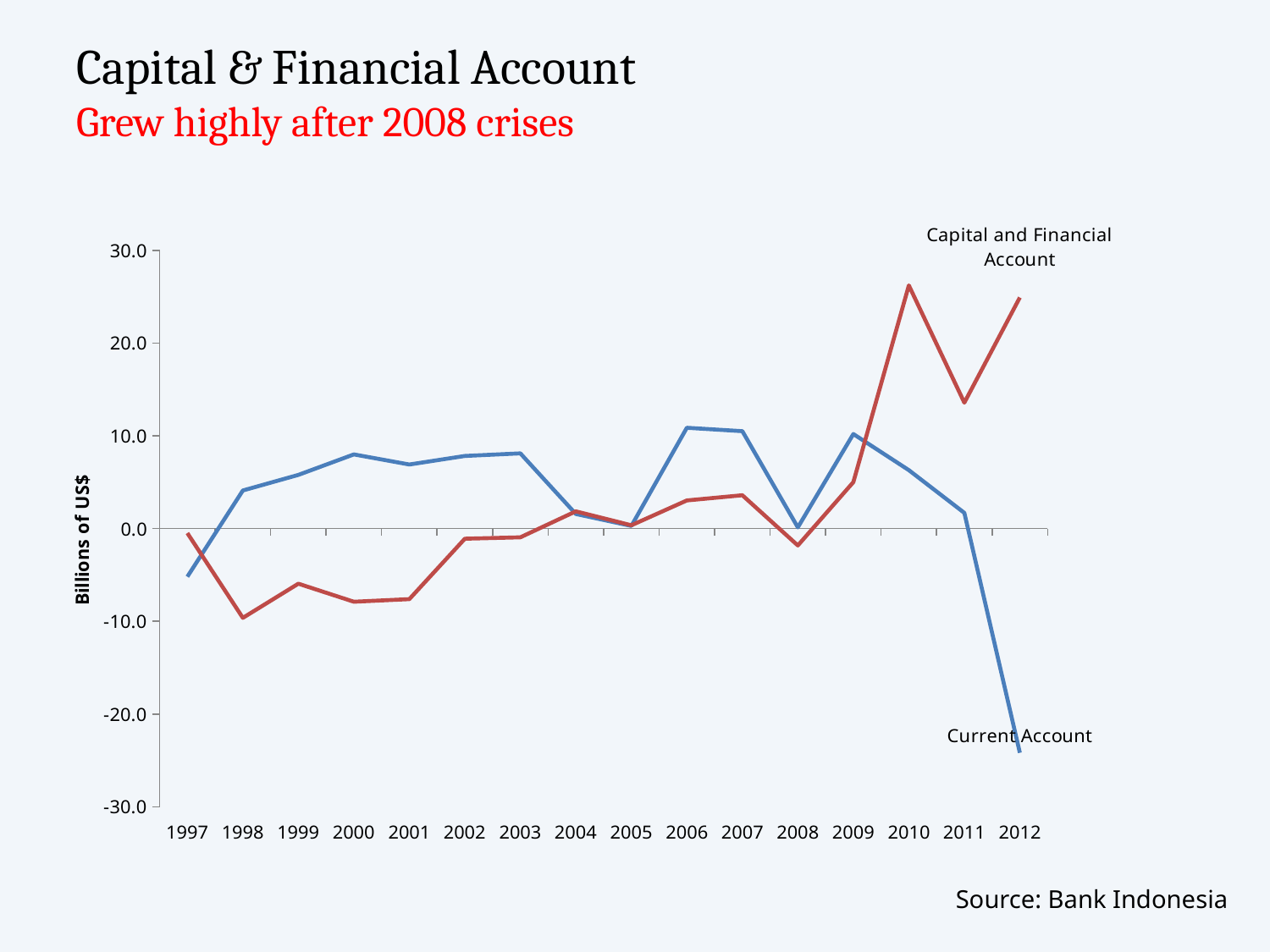
What is the title of the vertical axis? Billions of US$ In which year does the Capital and Financial Account line reach its highest value? 2010 In which year does the Current Account line reach its lowest value? 2012 Is the value for Current Account in 2012 greater or less than -20.0? less Is the value for Capital and Financial Account in 2001 greater or less than 0.0? less What kind of chart is shown on the slide? Line chart In which year does the Capital and Financial Account line reach its lowest value? 1998 Is the value for Capital and Financial Account in 2010 greater or less than 20.0? greater Does the Current Account line rise or fall from 2009 to 2012? Fall In 2012, which series has the higher value, Capital and Financial Account or Current Account? Capital and Financial Account How many years are shown on the x axis of the chart? 16 How many series are plotted on the chart? 2